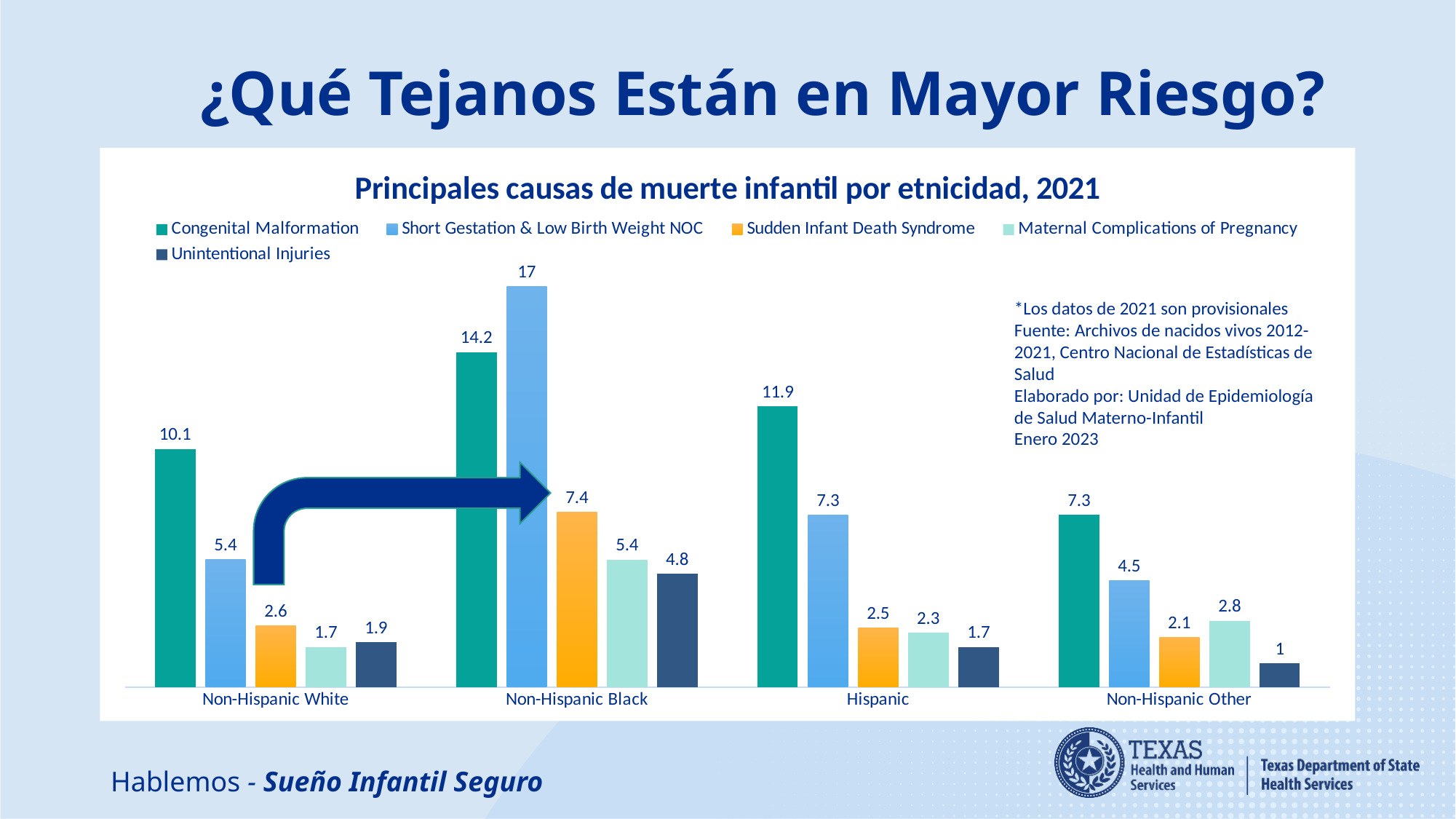
What is the title of the chart? Principales causas de muerte infantil por etnicidad, 2021 What is the value for Congenital Malformation in the Non-Hispanic Black group? 14.2 How many ethnic groups are shown on the x axis? 4 What is the value for Unintentional Injuries in the Non-Hispanic Other group? 1 What is the value for Sudden Infant Death Syndrome in the Non-Hispanic White group? 2.6 What is the value for Short Gestation & Low Birth Weight NOC in the Hispanic group? 7.3 Which ethnic group has the highest value for Short Gestation & Low Birth Weight NOC? Non-Hispanic Black What kind of chart is shown on the slide? Bar chart What is the difference between the Congenital Malformation values for Non-Hispanic Black and Non-Hispanic White? 4.1 Which ethnic group has the lowest value for Congenital Malformation? Non-Hispanic Other How many series does the legend list? 5 Which is larger: Sudden Infant Death Syndrome for Non-Hispanic Black or for Hispanic? Non-Hispanic Black